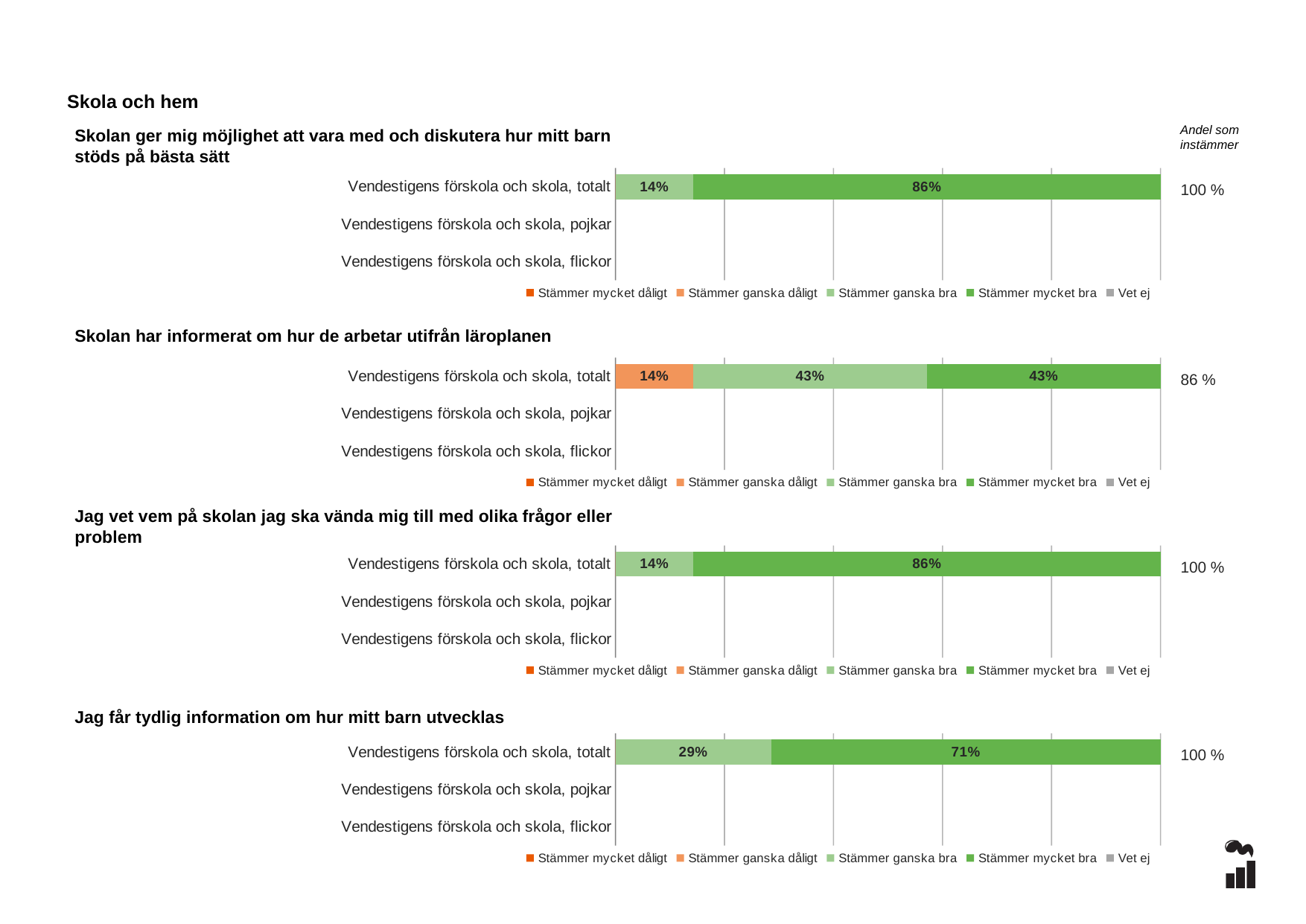
In the chart titled "Jag vet vem på skolan jag ska vända mig till med olika frågor eller problem", which series has the largest share for "Vendestigens förskola och skola, totalt"? Stämmer mycket bra What "Andel som instämmer" value is shown next to the chart titled "Skolan har informerat om hur de arbetar utifrån läroplanen"? 86 % In the chart titled "Skolan ger mig möjlighet att vara med och diskutera hur mitt barn stöds på bästa sätt", what is the value of "Stämmer mycket bra" for "Vendestigens förskola och skola, totalt"? 86% How many categories are shown on the y axis of the chart titled "Jag får tydlig information om hur mitt barn utvecklas"? 3 In the chart titled "Skolan har informerat om hur de arbetar utifrån läroplanen", what is the value of "Stämmer ganska dåligt" for "Vendestigens förskola och skola, totalt"? 14% In the chart titled "Skolan har informerat om hur de arbetar utifrån läroplanen", which is larger for "Vendestigens förskola och skola, totalt": "Stämmer ganska dåligt" or "Stämmer ganska bra"? Stämmer ganska bra In the chart titled "Jag vet vem på skolan jag ska vända mig till med olika frågor eller problem", what is the value of "Stämmer ganska bra" for "Vendestigens förskola och skola, totalt"? 14% What kind of chart is used for "Skolan ger mig möjlighet att vara med och diskutera hur mitt barn stöds på bästa sätt"? Stacked bar chart In the chart titled "Skolan har informerat om hur de arbetar utifrån läroplanen", what is the total of the labelled segments for "Vendestigens förskola och skola, totalt"? 100% In the chart titled "Jag får tydlig information om hur mitt barn utvecklas", what is the value of "Stämmer ganska bra" for "Vendestigens förskola och skola, totalt"? 29% In the chart titled "Jag får tydlig information om hur mitt barn utvecklas", what is the difference between the "Stämmer mycket bra" and "Stämmer ganska bra" values for "Vendestigens förskola och skola, totalt"? 42% How many series does the legend list in the chart titled "Skola har informerat om hur de arbetar utifrån läroplanen"? 5